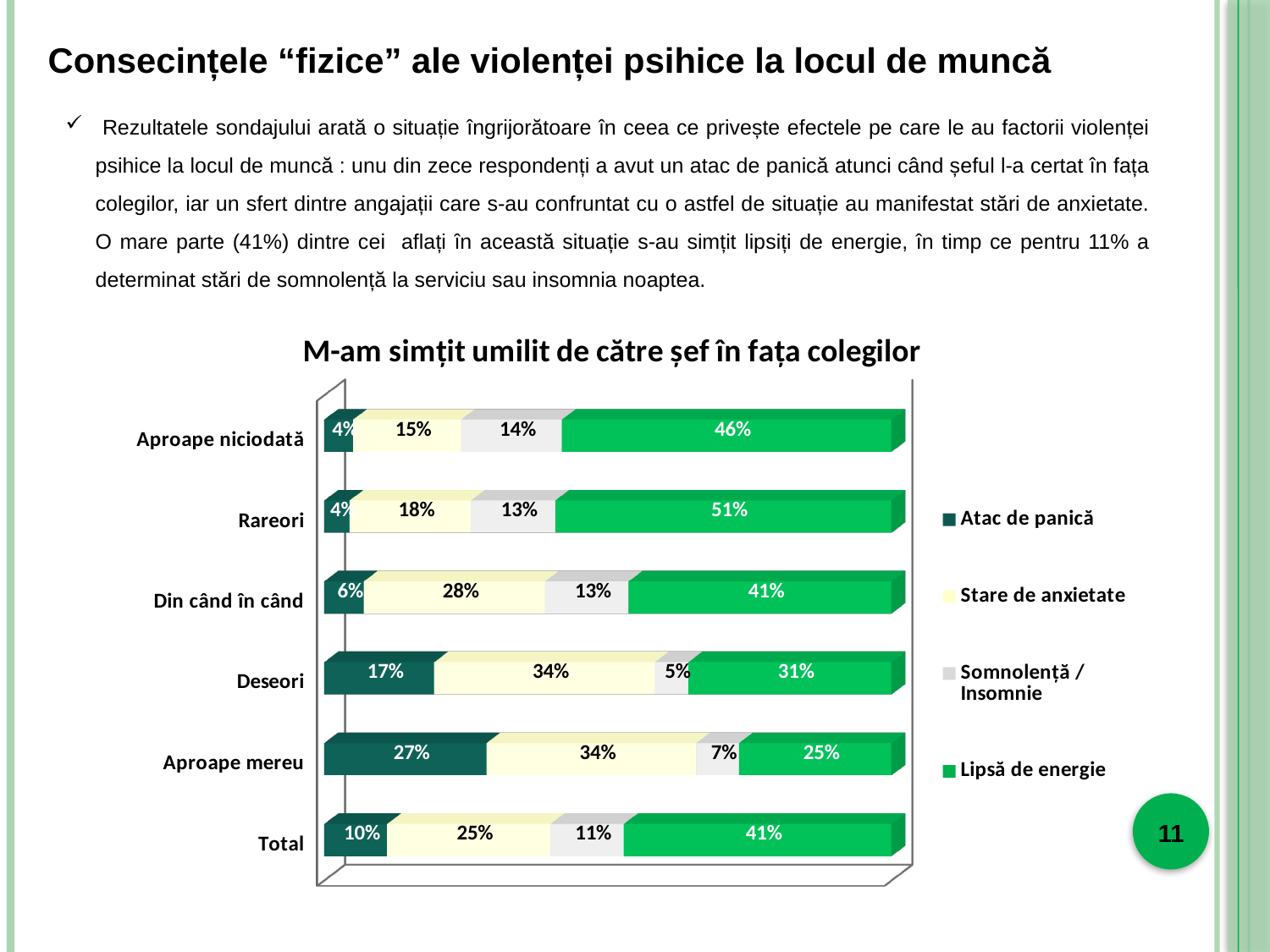
Which category has the lowest value for "Somnolență / Insomnie"? Deseori What is the value of "Atac de panică" for "Aproape mereu"? 27% What is the total of the stacked bar for "Total"? 87% Which category has the highest value for "Atac de panică"? Aproape mereu What type of chart is shown on the slide? Stacked bar chart What is the title of the chart? M-am simțit umilit de către șef în fața colegilor Which is larger: "Stare de anxietate" for "Din când în când" or for "Deseori"? Deseori What is the value of "Somnolență / Insomnie" for "Total"? 11% How many categories are shown on the chart? 6 What is the difference between "Lipsă de energie" for "Rareori" and for "Aproape mereu"? 26% How many series does the legend list? 4 What is the value of "Lipsă de energie" for "Rareori"? 51%